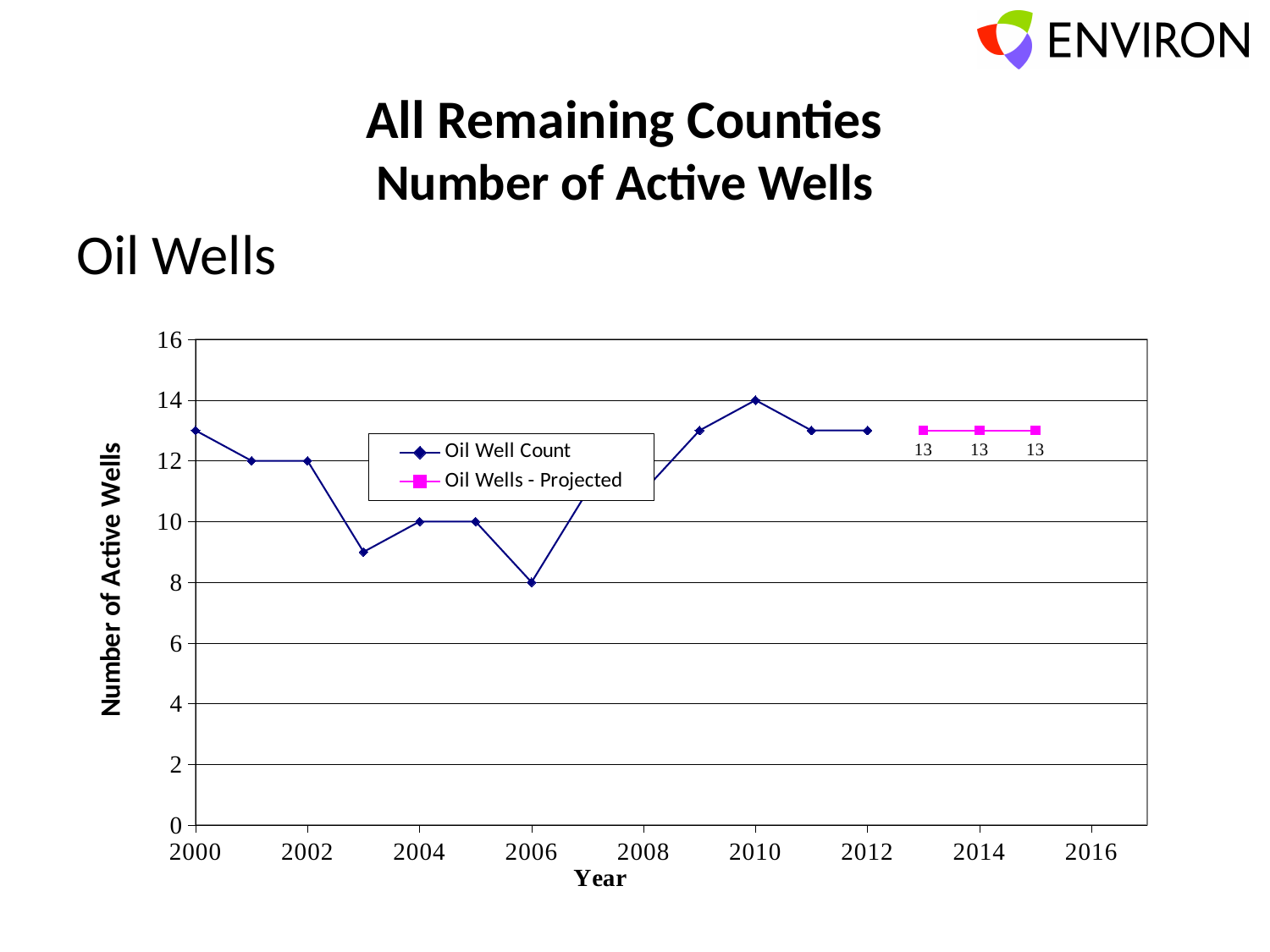
Does the Oil Well Count rise or fall from 2006 to 2010? Rise How many series does the legend list? 2 In which year is the Oil Well Count lowest? 2006 What is the Oil Well Count value for 2002? 12 What is the Oil Well Count value for 2006? 8 What is the difference between the Oil Well Count in 2010 and in 2006? 6 What type of chart is shown on the slide? Line chart What is the Oil Well Count value for 2010? 14 How many data points are plotted for the Oil Wells - Projected series? 3 In which year is the Oil Well Count highest? 2010 Is the Oil Well Count for 2003 greater or less than 10? less What is the projected number of oil wells for 2014? 13